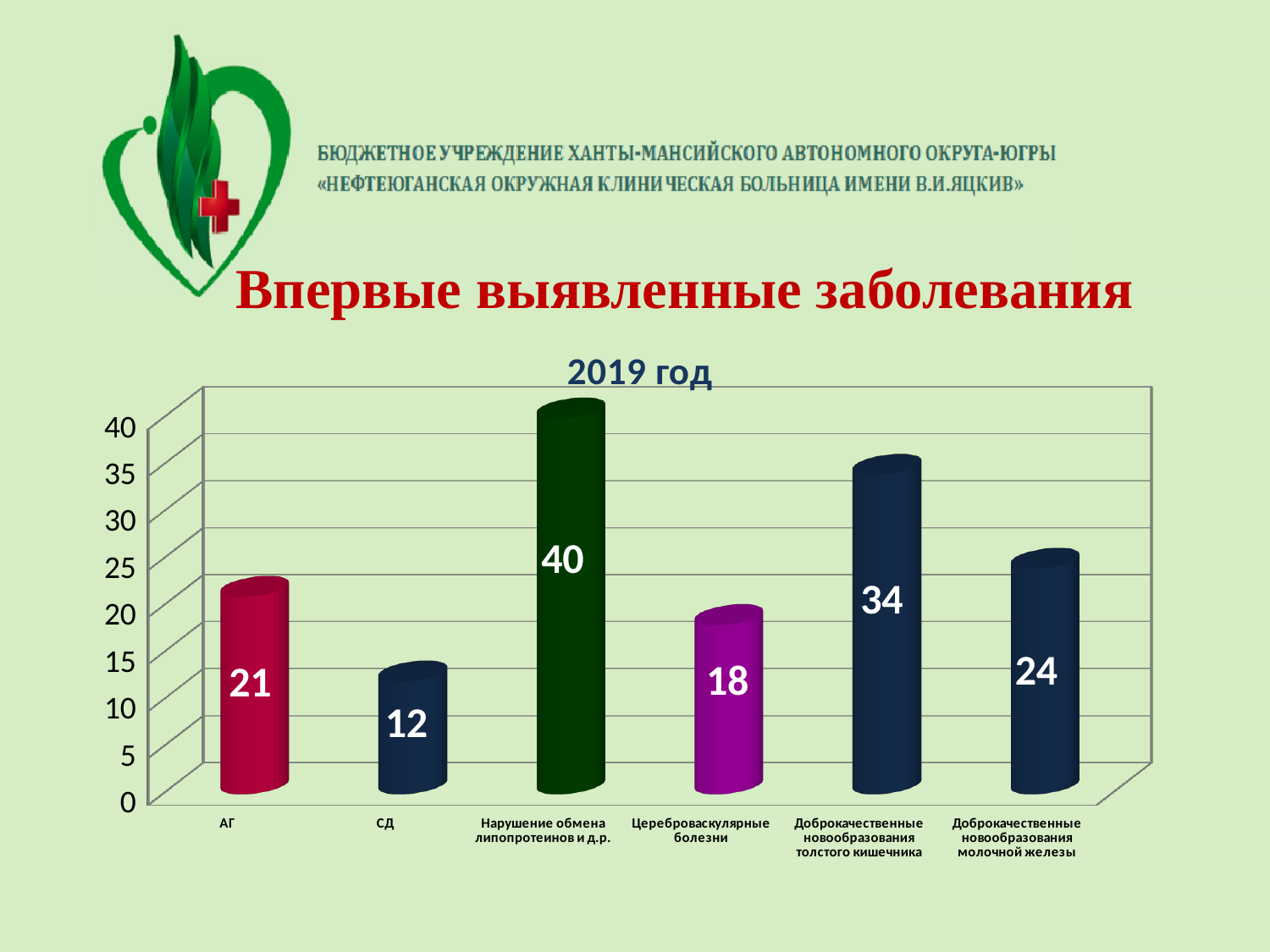
What is the value for Цереброваскулярные болезни? 18 What is the difference between the values for Нарушение обмена липопротеинов и д.р. and Доброкачественные новообразования толстого кишечника? 6 Which is larger, the value for АГ or the value for Цереброваскулярные болезни? АГ What is the value for АГ? 21 What is the value for СД? 12 What is the value for Доброкачественные новообразования молочной железы? 24 Is the value for Доброкачественные новообразования толстого кишечника greater or less than 30? greater Which category has the highest value? Нарушение обмена липопротеинов и д.р. Which category has the lowest value? СД What is the title of the chart? 2019 год How many categories are shown in the chart? 6 What kind of chart is shown on the slide? bar chart